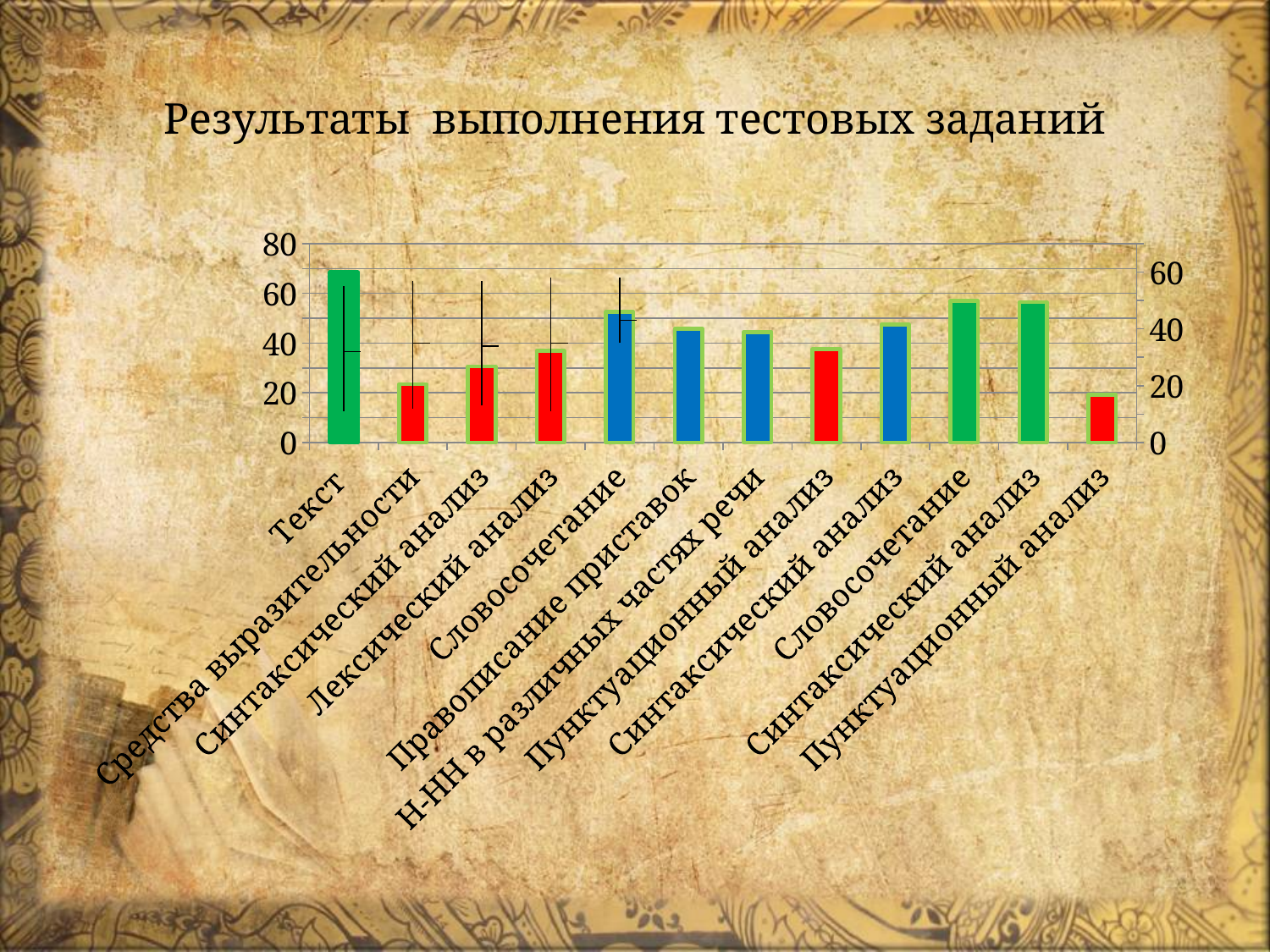
What kind of chart is shown on the slide? bar chart What is the title of the chart? Результаты выполнения тестовых заданий What is the highest tick value shown on the left vertical axis of the chart? 80 How many categories are plotted along the x axis of the chart? 12 Is the value for Средства выразительности greater or less than 40? less Which is larger, the value for Лексический анализ or the value for Правописание приставок? Правописание приставок Which is larger, the value for Текст or the value for Средства выразительности? Текст Is the value for Текст greater or less than 40? greater Which category has the highest bar in the chart? Текст Is the value for Лексический анализ greater or less than 40? less Which category has the lowest bar in the chart? Пунктуационный анализ (rightmost bar)